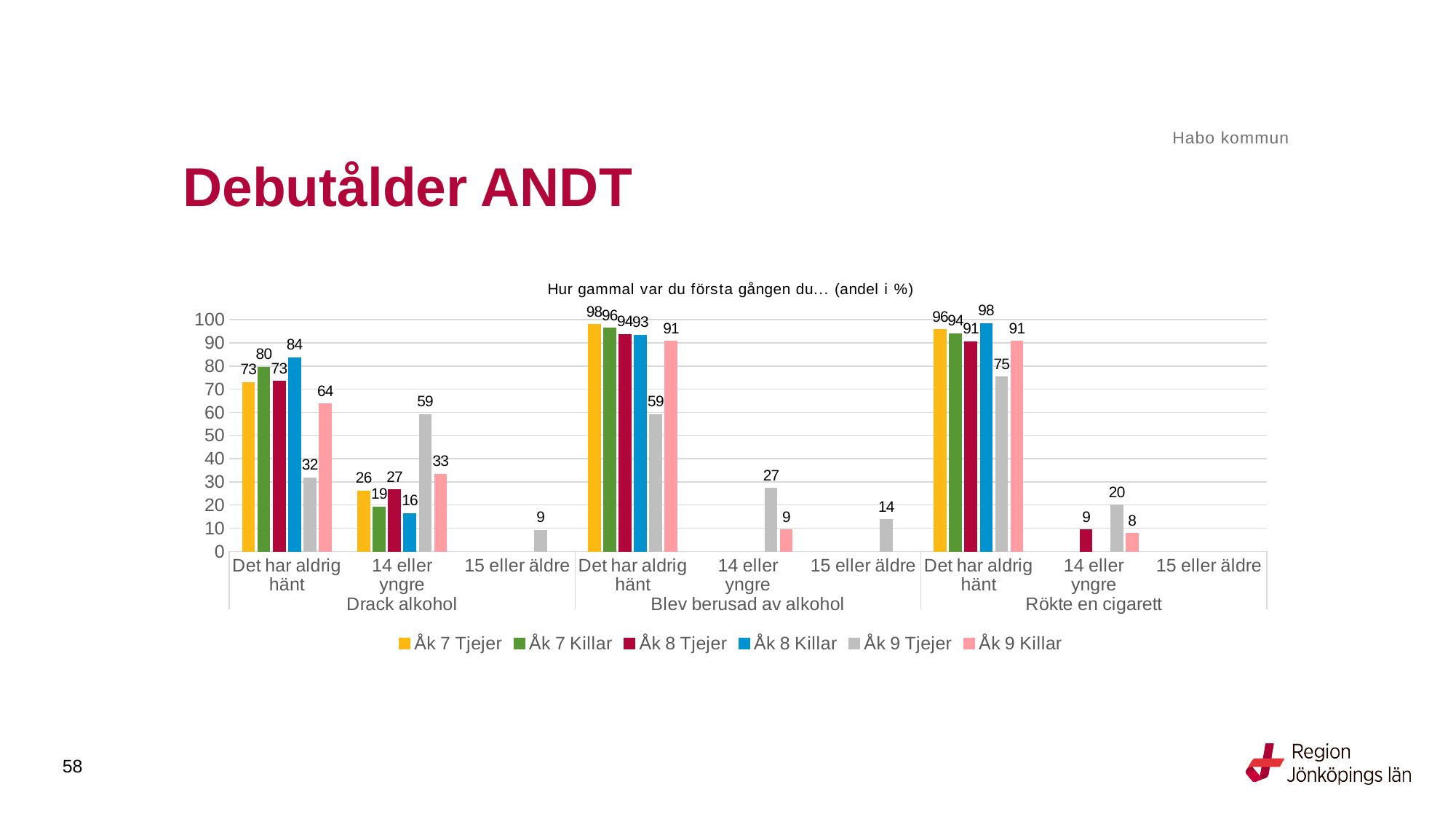
What is the difference between Åk 8 Killar and Åk 9 Tjejer under "Det har aldrig hänt" in the "Drack alkohol" group? 52 How many series does the legend list? 6 Which series has the lowest value under "Det har aldrig hänt" in the "Rökte en cigarett" group? Åk 9 Tjejer Which colour represents Åk 9 Tjejer in the chart? Grey Which series has the highest value under "Det har aldrig hänt" in the "Blev berusad av alkohol" group? Åk 7 Tjejer Under "14 eller yngre" in the "Blev berusad av alkohol" group, which is larger: Åk 9 Tjejer or Åk 9 Killar? Åk 9 Tjejer What is the value for Åk 9 Tjejer under "14 eller yngre" in the "Rökte en cigarett" group? 20 What is the value for Åk 9 Tjejer under "Det har aldrig hänt" in the "Blev berusad av alkohol" group? 59 What is the value for Åk 9 Tjejer under "14 eller yngre" in the "Drack alkohol" group? 59 What kind of chart is shown on the slide? Bar chart What is the value for Åk 8 Killar under "Det har aldrig hänt" in the "Drack alkohol" group? 84 What is the title of the chart? Hur gammal var du första gången du… (andel i %)